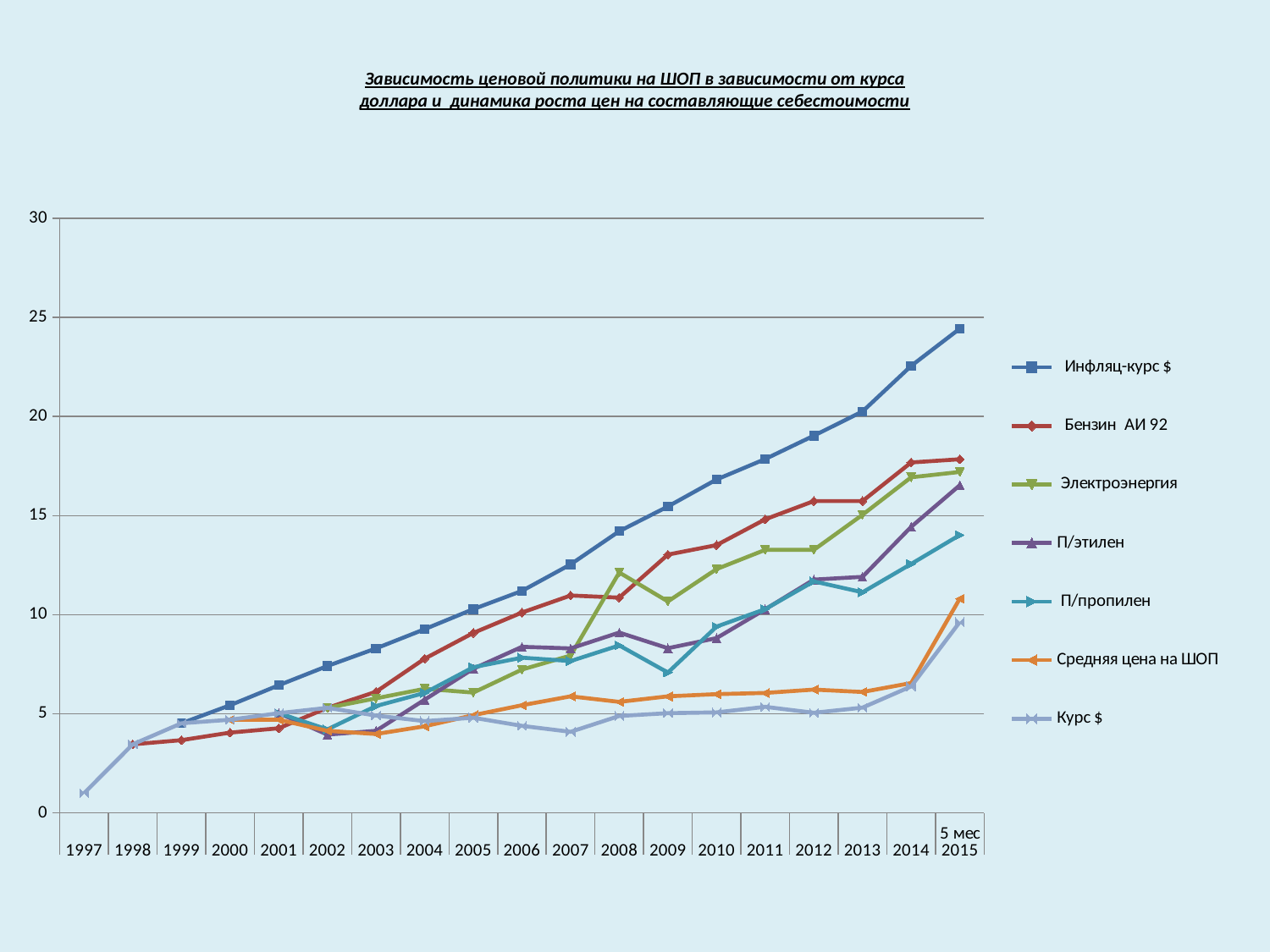
Does the Инфляц-курс $ series rise or fall from 1997 to 5 мес 2015? rise In 5 мес 2015, which is higher: Бензин АИ 92 or Средняя цена на ШОП? Бензин АИ 92 Which series is drawn in orange? Средняя цена на ШОП Is the value for Курс $ in 1997 greater or less than 5? less In 2009, which is higher: Бензин АИ 92 or Электроэнергия? Бензин АИ 92 How many time points are shown along the x axis? 19 Which series has the highest value in 5 мес 2015? Инфляц-курс $ What kind of chart is shown on the slide? line chart Is the value for Электроэнергия in 2008 greater or less than 10? greater Which series has the lowest value in 5 мес 2015? Курс $ Is the value for Инфляц-курс $ in 5 мес 2015 greater or less than 20? greater How many series does the legend list? 7